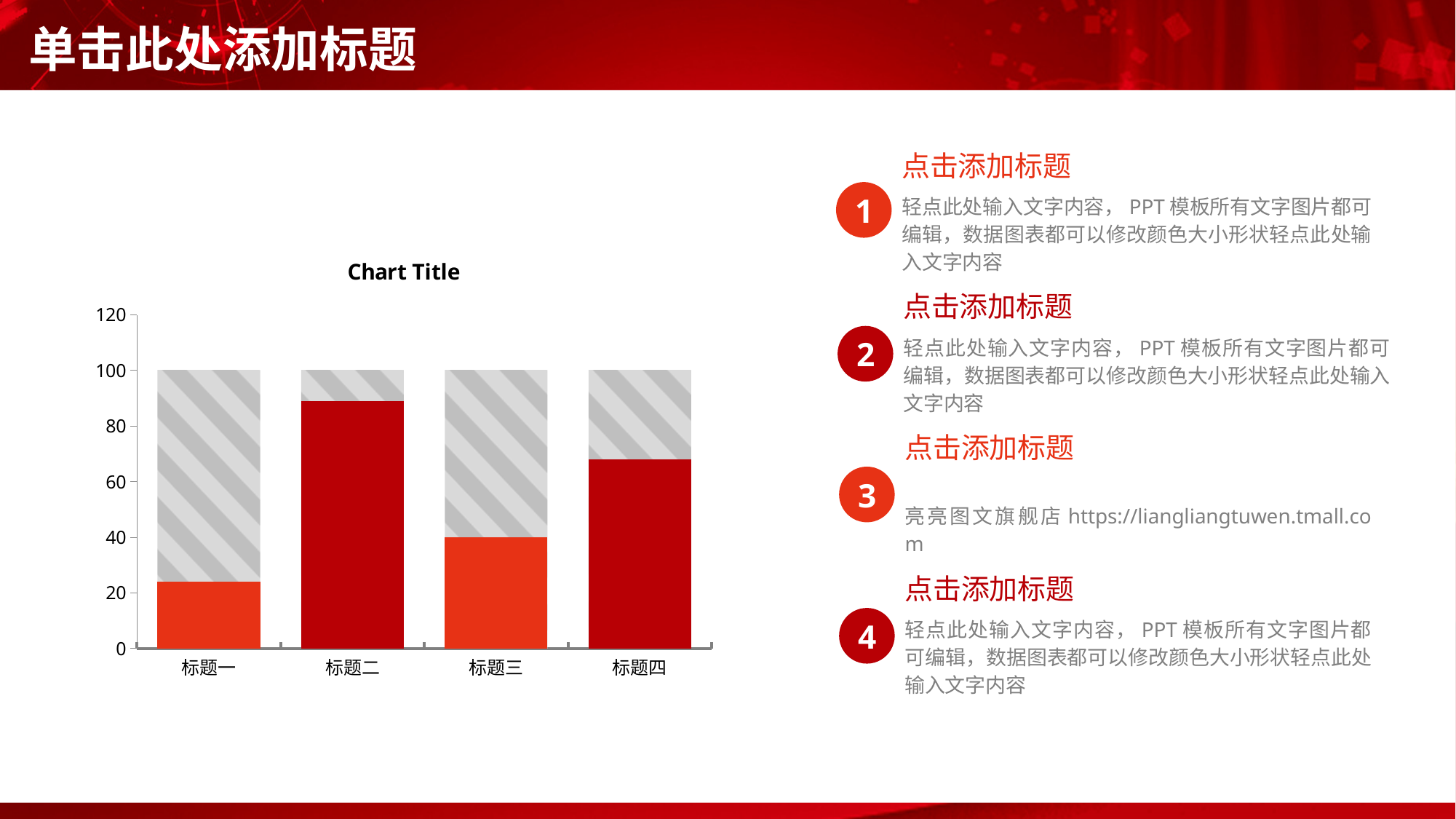
Is the solid-coloured segment for 标题三 greater or less than 60? less What kind of chart is shown on the slide? bar chart Is the solid-coloured segment for 标题一 greater or less than 40? less Which category has the tallest solid-coloured (lower) segment? 标题二 What is the title of the chart? Chart Title Which has the larger solid-coloured segment, 标题三 or 标题四? 标题四 Which category has the shortest solid-coloured (lower) segment? 标题一 How many categories are shown on the x axis of the chart? 4 What value does the top of the full stacked bar for 标题二 reach on the y axis? 100 What value does the top of the full stacked bar for 标题一 reach on the y axis? 100 Is the solid-coloured segment for 标题四 greater or less than 60? greater